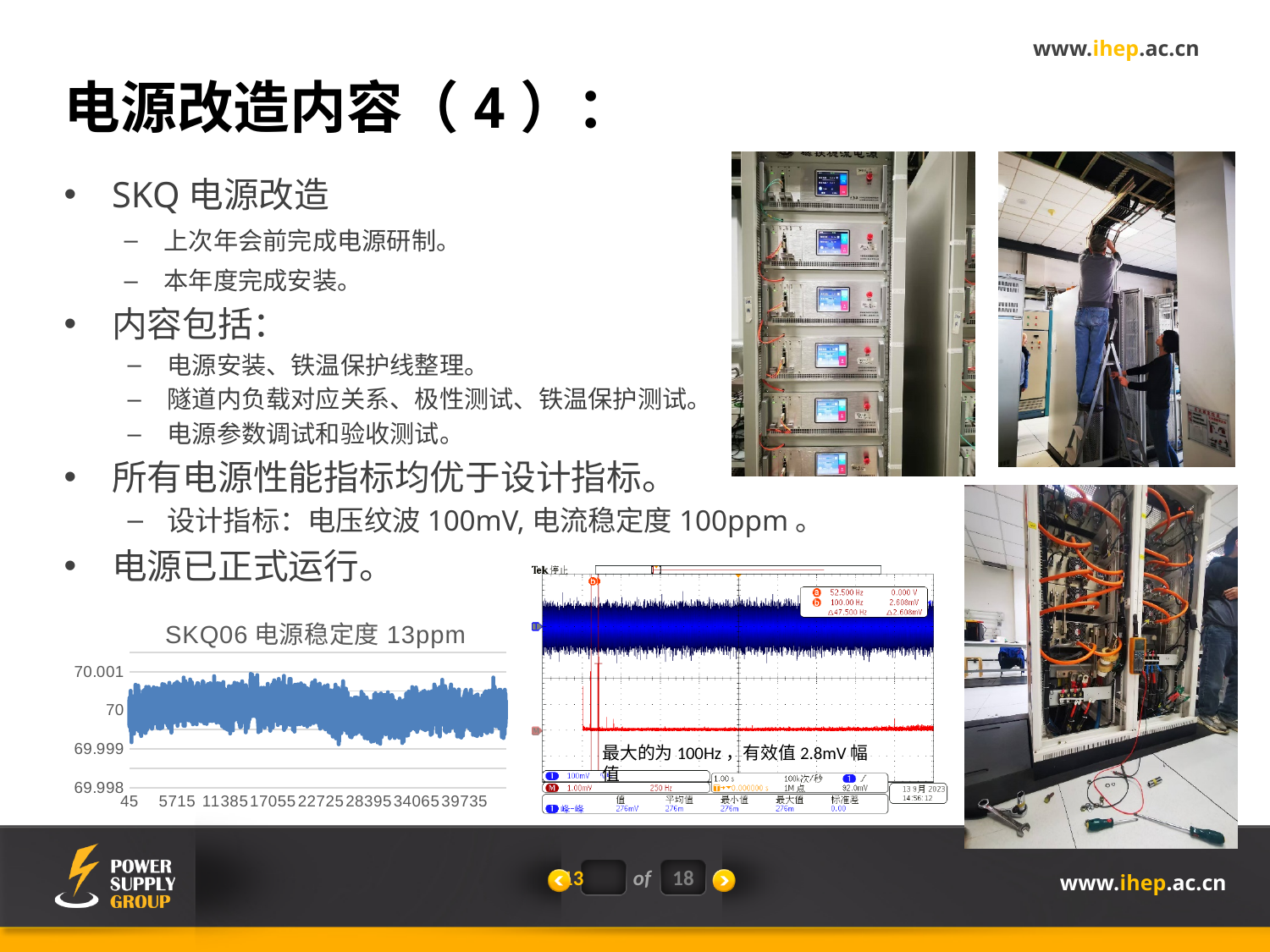
In the SKQ06 电源稳定度 chart, are the plotted values greater or less than 69.998? greater What kind of chart is shown at the bottom left of the slide? line chart What is the title of the chart at the bottom left of the slide? SKQ06 电源稳定度 13ppm In the SKQ06 电源稳定度 chart, what is the last tick label on the horizontal axis? 39735 In the SKQ06 电源稳定度 chart, which horizontal axis tick label comes immediately after 17055? 22725 In the SKQ06 电源稳定度 chart, what is the highest value labelled on the vertical axis? 70.001 What colour is the plotted line in the SKQ06 电源稳定度 chart? blue In the SKQ06 电源稳定度 chart, what is the first tick label on the horizontal axis? 45 In the SKQ06 电源稳定度 chart, what is the lowest value labelled on the vertical axis? 69.998 In the SKQ06 电源稳定度 chart, is the plotted line centred above or below 69.999? above How many tick labels are printed along the horizontal axis of the SKQ06 电源稳定度 chart? 8 In the SKQ06 电源稳定度 chart, do the plotted values show a clear rising or falling trend along the x axis, or do they stay roughly flat? roughly flat